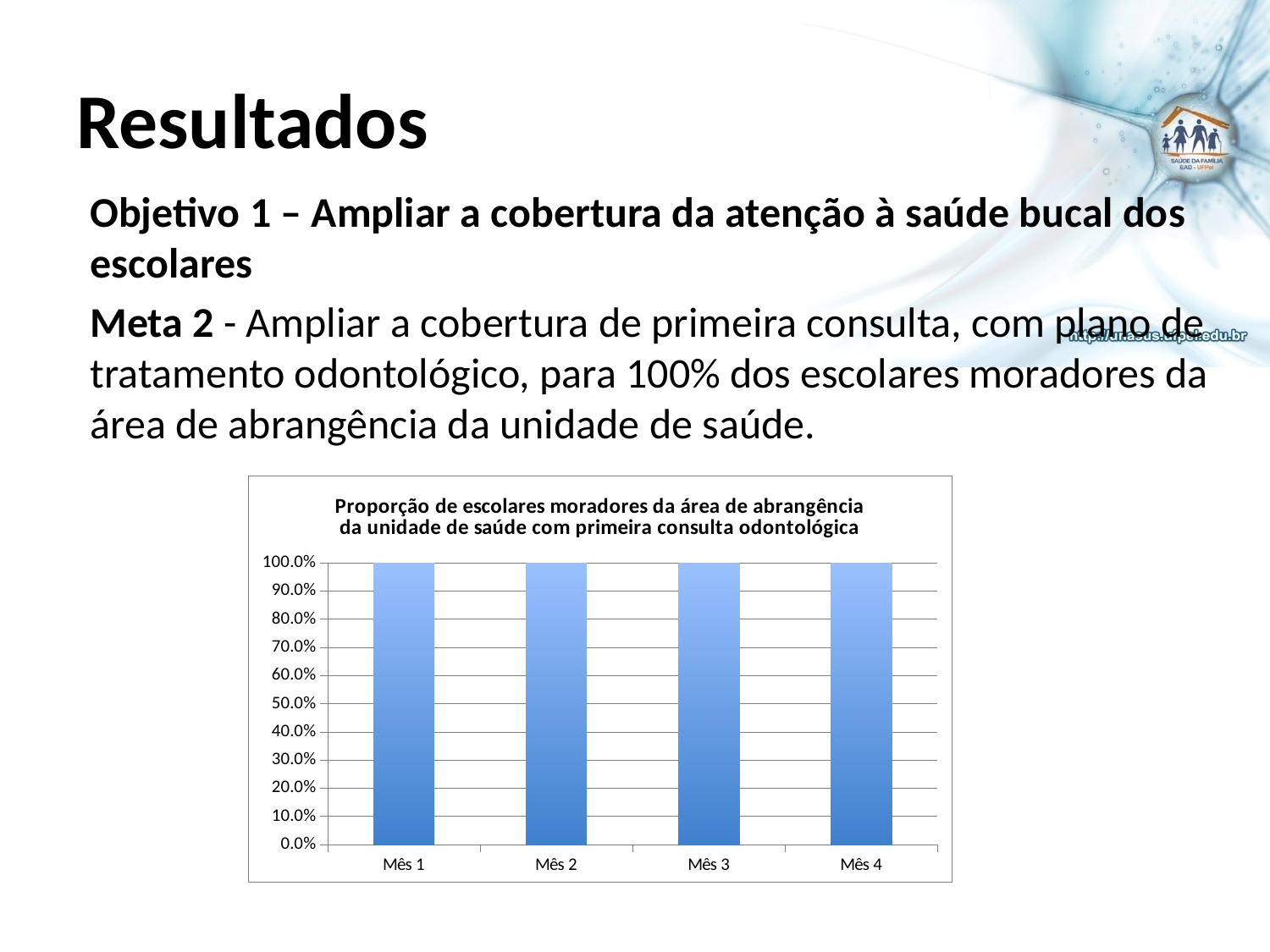
What is the highest value shown on the y axis? 100.0% What kind of chart is shown on the slide? bar chart Is the value for Mês 2 greater or less than 90.0%? greater What is the difference between the values for Mês 1 and Mês 4? 0.0% What is the title of the chart? Proporção de escolares moradores da área de abrangência da unidade de saúde com primeira consulta odontológica How many categories (months) are shown on the x axis? 4 What is the value for Mês 4? 100.0% Do the values rise, fall or stay the same from Mês 1 to Mês 4? stay the same Is the value for Mês 4 greater or less than 50.0%? greater What is the value for Mês 1? 100.0% What is the value for Mês 3? 100.0%